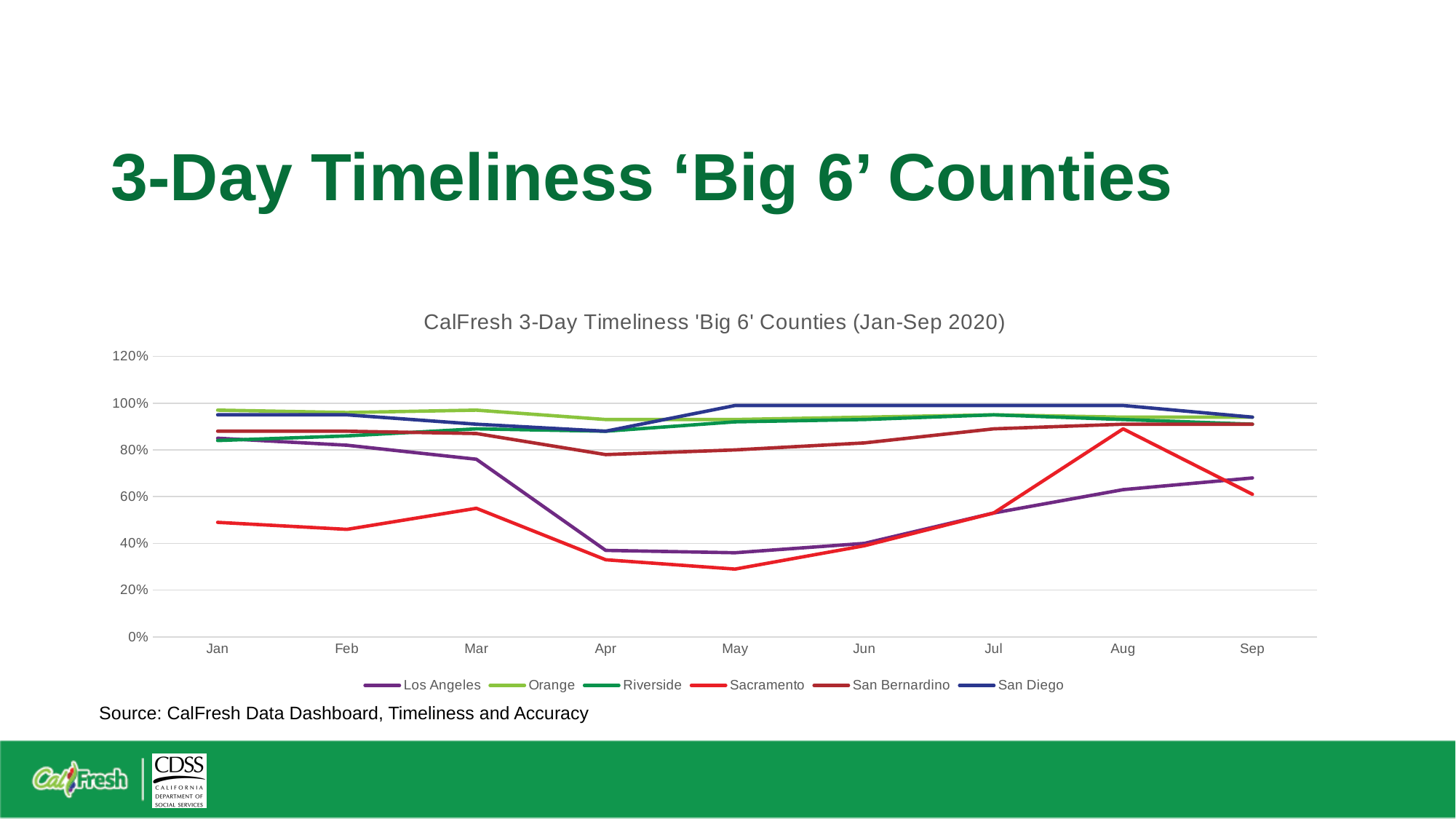
Which county has the lowest value in May? Sacramento Is the value for San Diego in May greater or less than 80%? greater Is the value for Sacramento in May greater or less than 40%? less Does the value for Los Angeles rise or fall from May to Sep? rise Is the value for Los Angeles in Apr greater or less than 60%? less Which county has the highest value in May? San Diego How many series does the legend list? 6 What kind of chart is shown on the slide? line chart Does the value for Sacramento rise or fall from Aug to Sep? fall What is the title of the chart? CalFresh 3-Day Timeliness 'Big 6' Counties (Jan-Sep 2020) How many months are plotted along the x axis? 9 In Aug, which is larger: the value for Sacramento or the value for Los Angeles? Sacramento